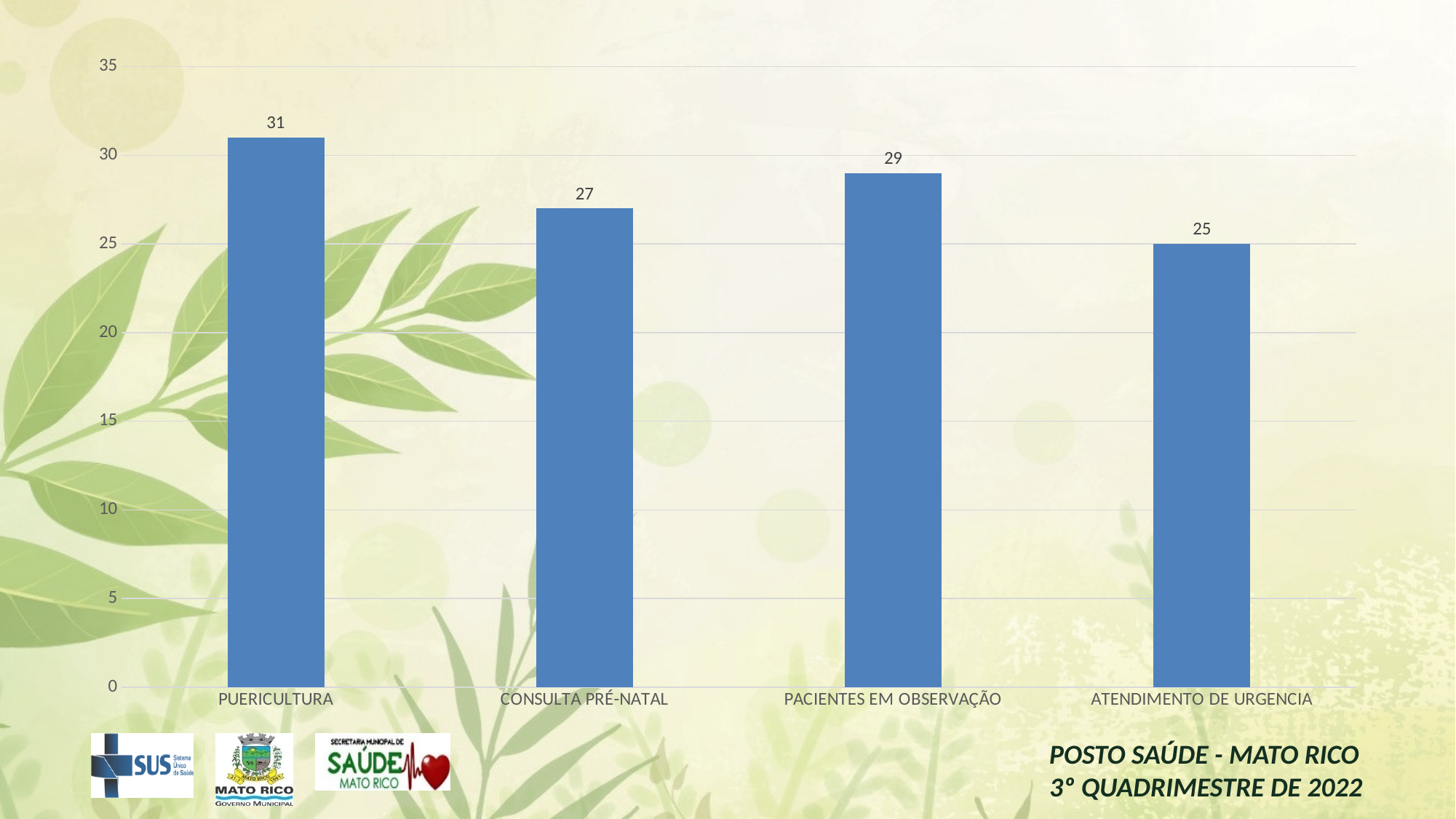
What is the value for ATENDIMENTO DE URGENCIA? 25 What is the value for CONSULTA PRÉ-NATAL? 27 Which category has the lowest value? ATENDIMENTO DE URGENCIA Which category has the highest value? PUERICULTURA What is the value for PACIENTES EM OBSERVAÇÃO? 29 How many categories are shown in the chart? 4 Is the value for PUERICULTURA greater or less than 30? greater What is the difference between the values for PACIENTES EM OBSERVAÇÃO and CONSULTA PRÉ-NATAL? 2 What is the value for PUERICULTURA? 31 Which is larger, the value for CONSULTA PRÉ-NATAL or the value for PACIENTES EM OBSERVAÇÃO? PACIENTES EM OBSERVAÇÃO What kind of chart is shown on the slide? bar chart What is the difference between the values for PUERICULTURA and ATENDIMENTO DE URGENCIA? 6